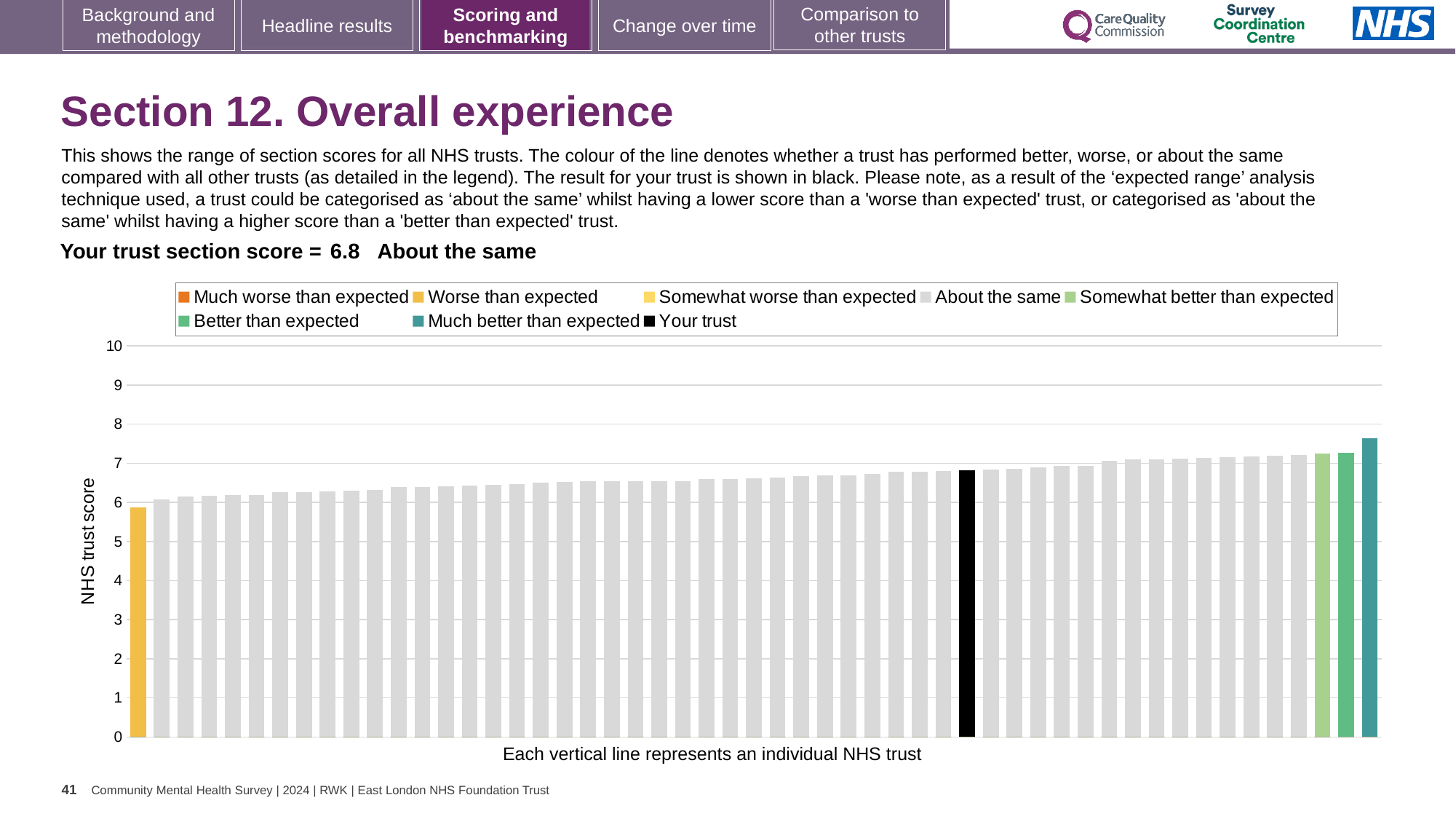
Is the value of the tallest bar (the teal bar at the far right) greater or less than 7? greater Is the value of the tallest bar greater or less than 8? less Which legend category does the tallest bar in the chart belong to? Much better than expected Is the value for your trust (the black bar) greater or less than 6? greater How many bars in the chart are coloured something other than grey? 5 Do the bar values rise or fall from left to right across the chart? rise What category is your trust's section score placed in, according to the text above the chart? About the same How many entries does the chart legend list? 8 What is the label on the vertical axis of the chart? NHS trust score Which legend category does the shortest bar in the chart belong to? Worse than expected What kind of chart is shown on the slide? bar chart What is the section score for your trust shown on the slide? 6.8